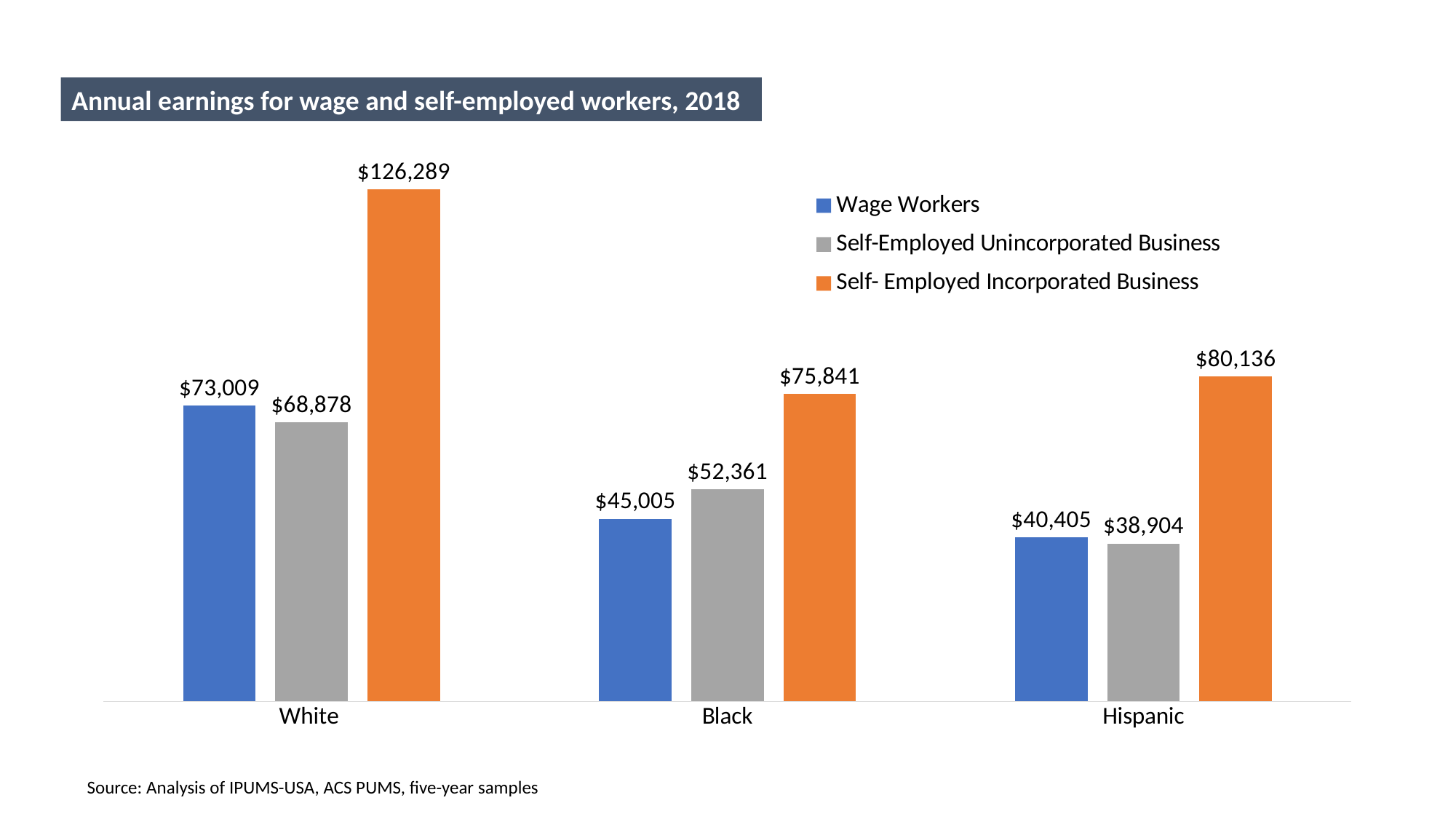
What are the annual earnings for Hispanic self-employed incorporated business workers? $80,136 What are the annual earnings for White wage workers? $73,009 What is the difference between the annual earnings of White self-employed incorporated business workers and White wage workers? $53,280 What are the annual earnings for Black self-employed unincorporated business workers? $52,361 How many racial/ethnic groups are shown on the x axis? 3 What kind of chart is shown on the slide? Bar chart Which group has the highest annual earnings among self-employed incorporated business workers? White What is the title of the chart? Annual earnings for wage and self-employed workers, 2018 Which is larger for Black workers: wage workers' earnings or self-employed unincorporated business earnings? Self-Employed Unincorporated Business Which group has the lowest annual earnings among wage workers? Hispanic How many series does the legend list? 3 Which colour represents Wage Workers in the legend? Blue